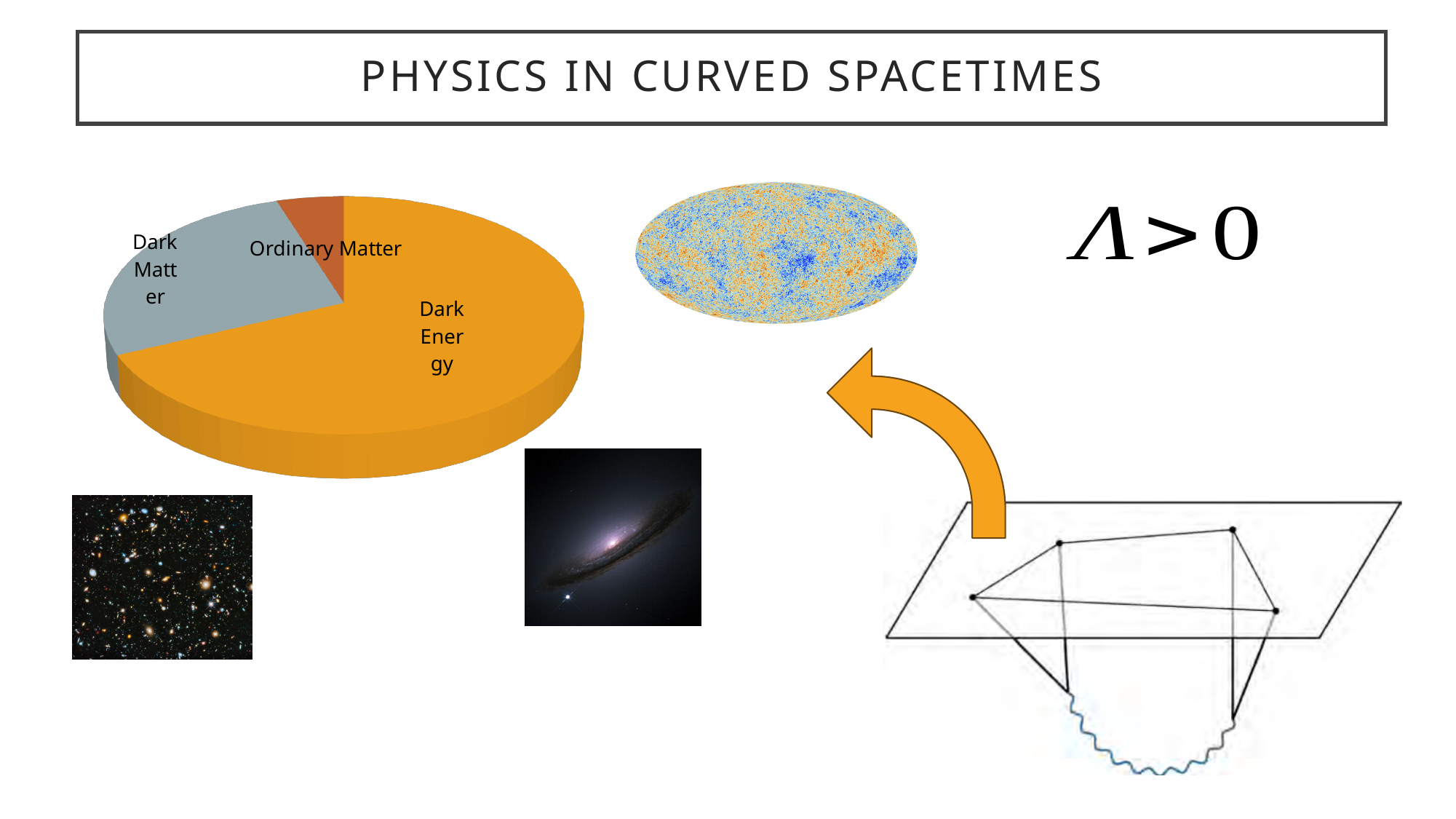
How many slices does the pie chart have? 3 In the pie chart, which is larger: Dark Matter or Ordinary Matter? Dark Matter Which slice of the pie chart is the smallest? Ordinary Matter Does the Dark Energy slice take up more or less than half of the pie chart? more What colour is the Dark Energy slice in the pie chart? orange Which slice of the pie chart is the largest? Dark Energy In the pie chart, which is larger: Dark Energy or Dark Matter? Dark Energy What colour is the Dark Matter slice in the pie chart? grey What are the labels of the three slices in the pie chart? Dark Energy, Dark Matter, Ordinary Matter What kind of chart is shown on the left of the slide? pie chart